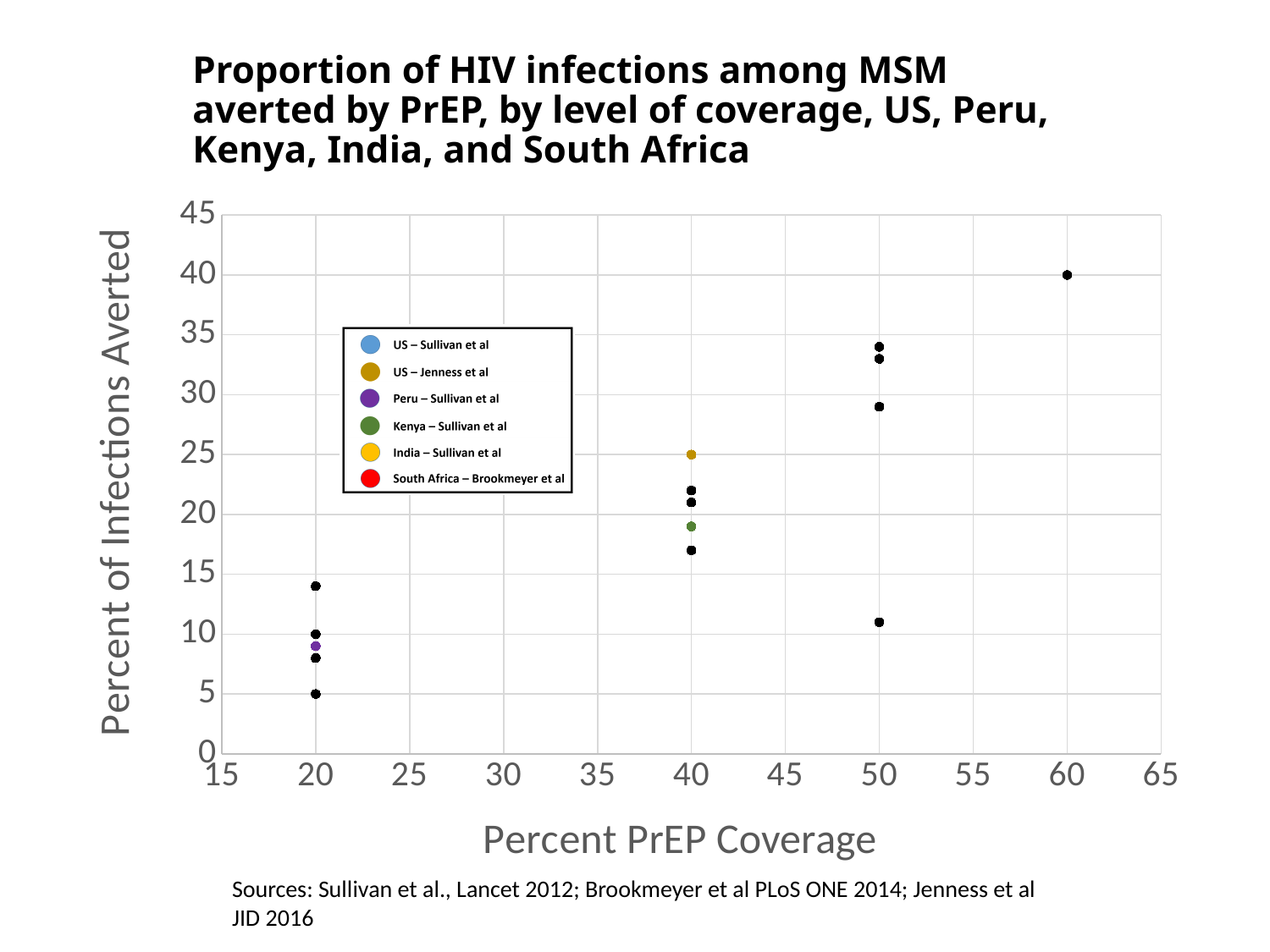
What is the label of the x axis? Percent PrEP Coverage Is the lowest value plotted at 50% PrEP coverage greater or less than 15? less Is the highest value plotted at 50% PrEP coverage greater or less than 30? greater At which level of PrEP coverage is the highest percent of infections averted plotted? 60 What kind of chart is shown on the slide? Scatter chart What is the highest percent of infections averted plotted at 40% PrEP coverage? 25 How many series does the legend list? 6 Overall, does the percent of infections averted rise or fall as PrEP coverage increases? Rise What is the lowest percent of infections averted plotted at 20% PrEP coverage? 5 At which level of PrEP coverage is the lowest percent of infections averted plotted? 20 What is the percent of infections averted for the point at 60% PrEP coverage? 40 What is the title of the chart? Proportion of HIV infections among MSM averted by PrEP, by level of coverage, US, Peru, Kenya, India, and South Africa